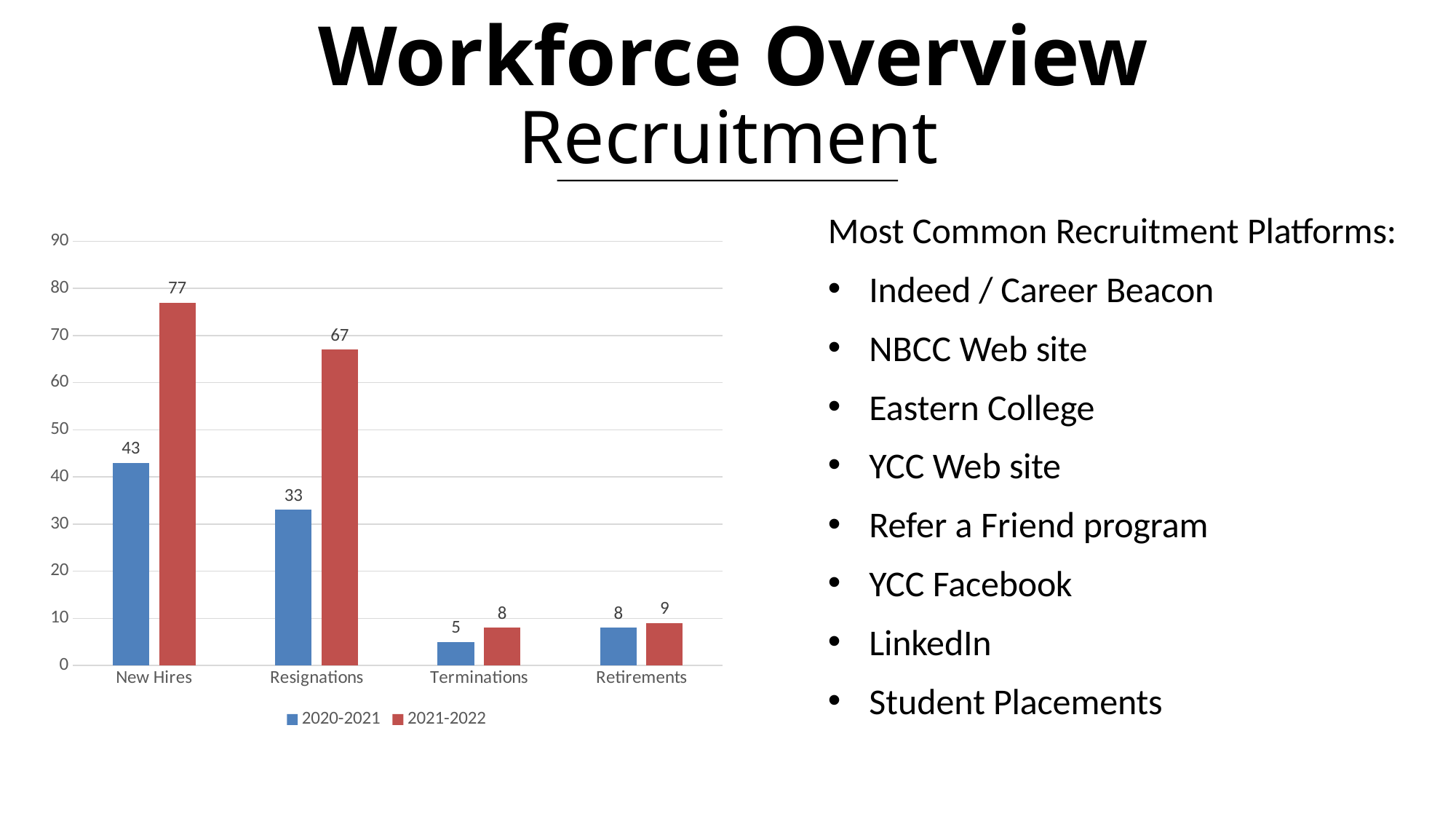
What is the value for New Hires in the 2021-2022 series? 77 Which category has the highest value in the 2021-2022 series? New Hires What is the value for Terminations in the 2020-2021 series? 5 What is the difference between the 2021-2022 and 2020-2021 values for New Hires? 34 How many series does the chart legend list? 2 What is the value for Resignations in the 2020-2021 series? 33 What is the difference between the 2021-2022 and 2020-2021 values for Resignations? 34 Which category has the lowest value in the 2020-2021 series? Terminations How many categories are shown on the x axis of the chart? 4 What is the value for Retirements in the 2021-2022 series? 9 Which is larger: Resignations in 2021-2022 or New Hires in 2020-2021? Resignations in 2021-2022 What kind of chart is shown on the slide? Bar chart